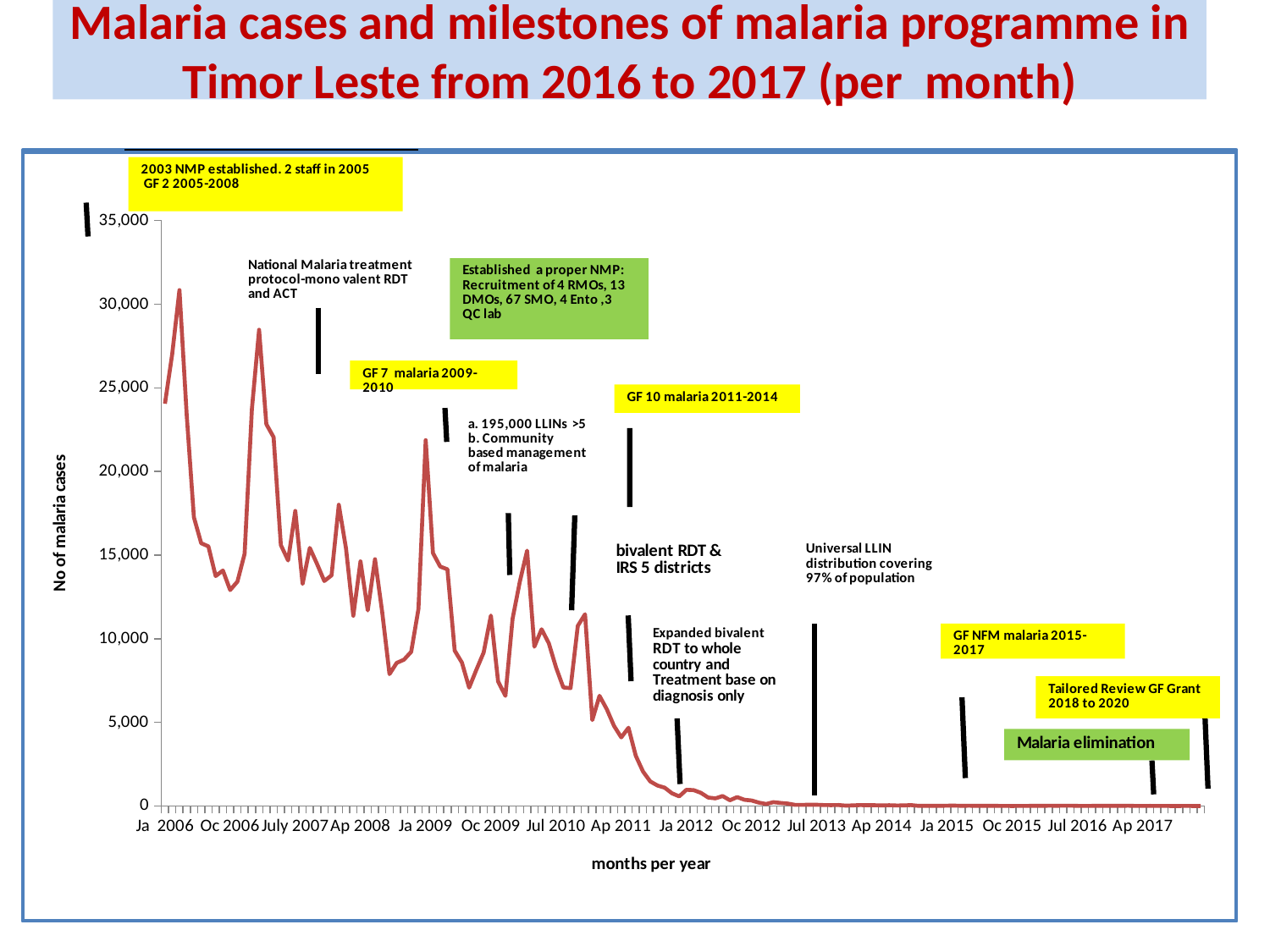
Is the value of malaria cases at Jul 2013 greater or less than 5,000? less Is the peak value of malaria cases around Ja 2009 greater or less than 20,000? greater What is the title of the vertical axis? No of malaria cases Is the value of malaria cases at Ja 2012 greater or less than 5,000? less What kind of chart is shown on the slide? line chart How many data series (lines) are plotted on the chart? 1 Which is larger: the peak of malaria cases in early 2006 or the peak around Ja 2009? early 2006 What is the highest value shown on the vertical axis? 35,000 Overall, do the monthly malaria cases rise or fall from 2006 to 2017? fall In which year does the line reach its highest number of malaria cases? 2006